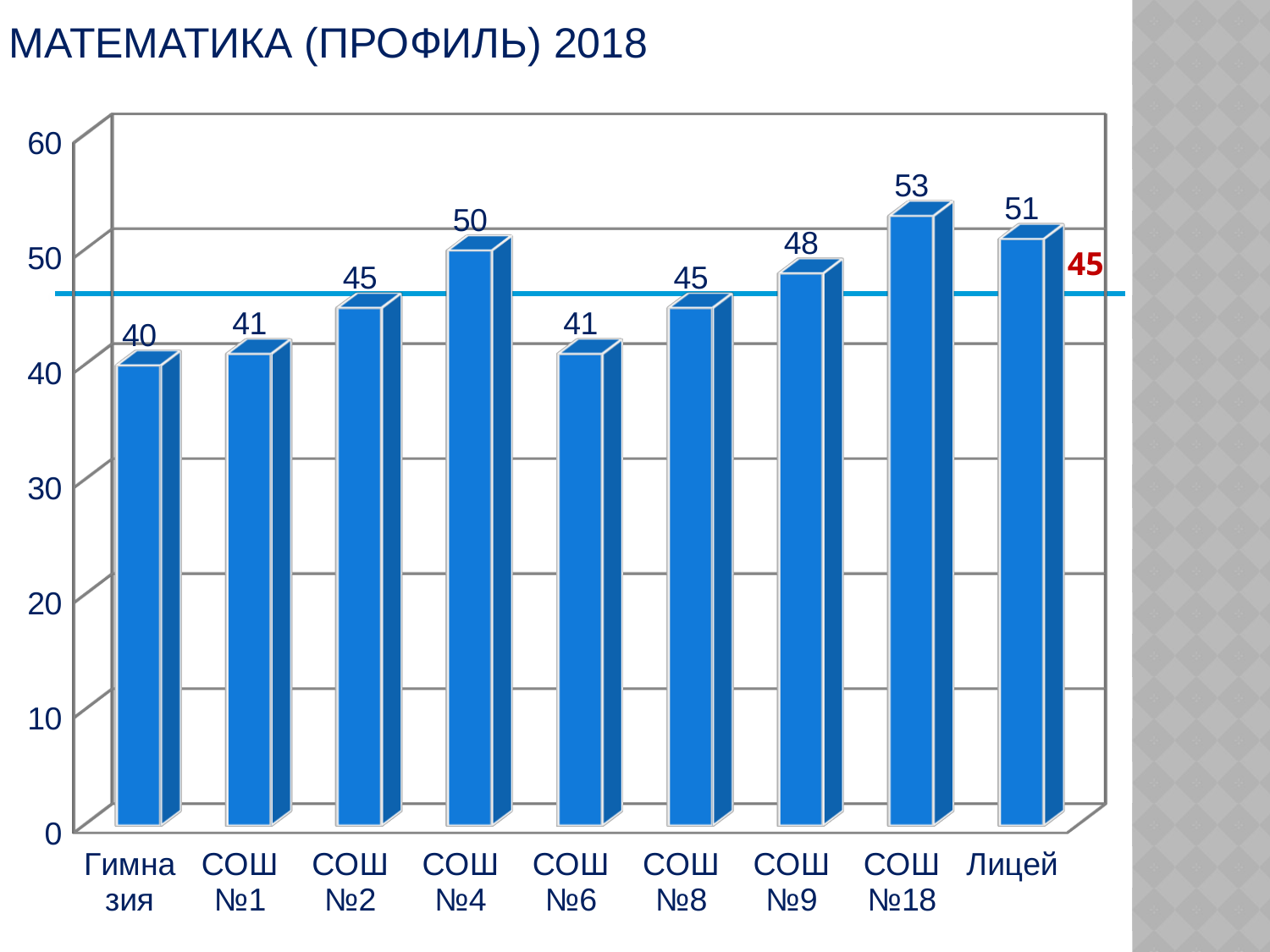
What is the value for Гимназия? 40 What is the difference between the values for СОШ №18 and СОШ №6? 12 Is the value for СОШ №1 greater or less than 50? less How many categories are shown on the x axis? 9 What is the value for Лицей? 51 Which category has the highest value? СОШ №18 What is the title of the slide? МАТЕМАТИКА (ПРОФИЛЬ) 2018 What is the value for СОШ №4? 50 Which is larger, the value for СОШ №9 or the value for СОШ №2? СОШ №9 What value is marked by the horizontal line across the chart? 45 What kind of chart is shown on the slide? bar chart Which category has the lowest value? Гимназия